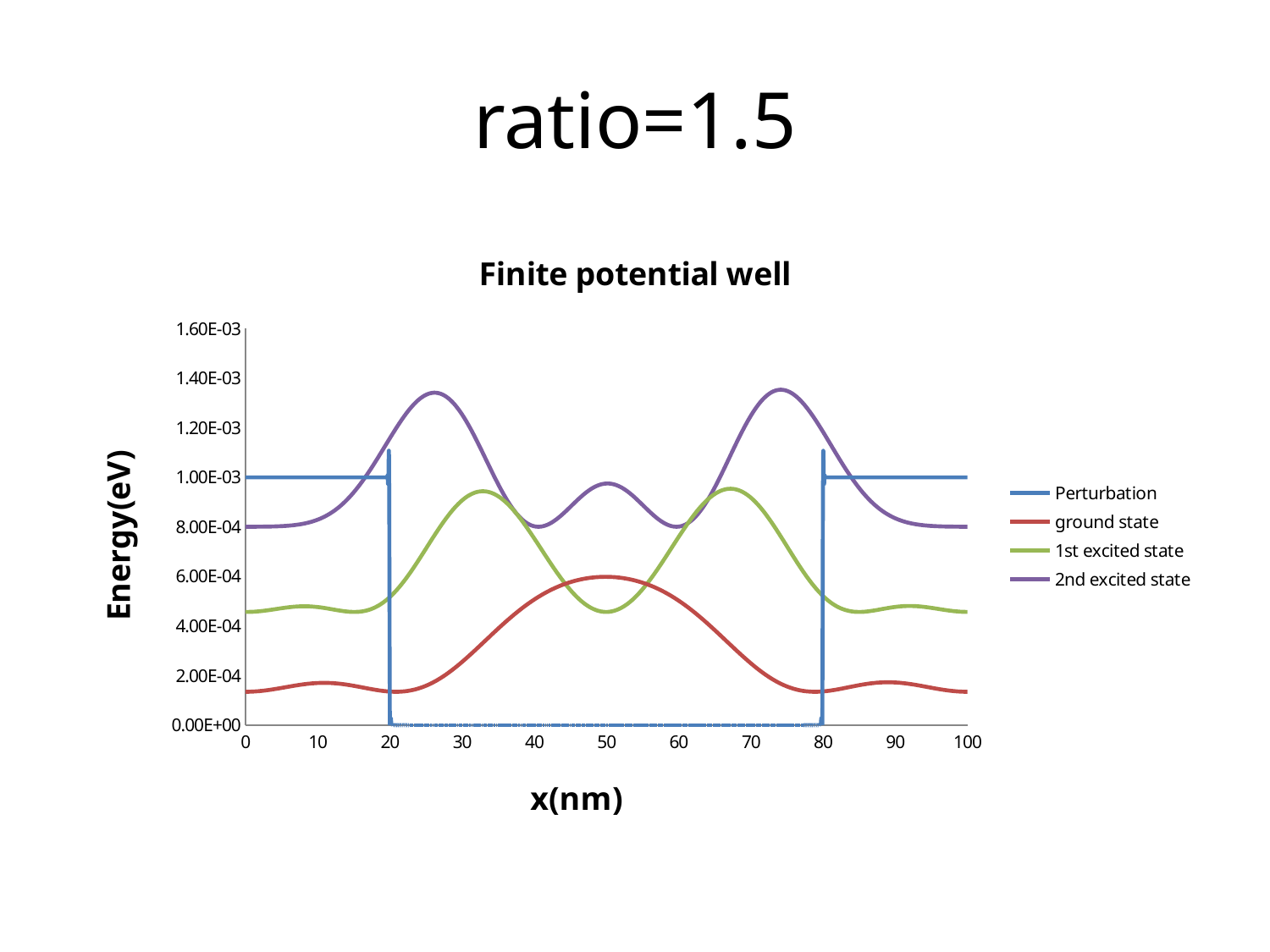
Is the value of the ground state at x = 0 greater or less than 2.00E-04? less Is the value of the 2nd excited state at x = 0 greater or less than 1.00E-03? less Is the value of the 1st excited state at x = 0 greater or less than 6.00E-04? less What is the title of the chart? Finite potential well What is the value of the Perturbation series at x = 50? 0.00E+00 Which series reaches the highest value on the chart? 2nd excited state What is the value of the Perturbation series at x = 0? 1.00E-03 What is the label of the vertical axis? Energy(eV) What kind of chart is shown on the slide? line chart At x = 50, which is higher: the ground state or the 1st excited state? ground state How many series does the chart legend list? 4